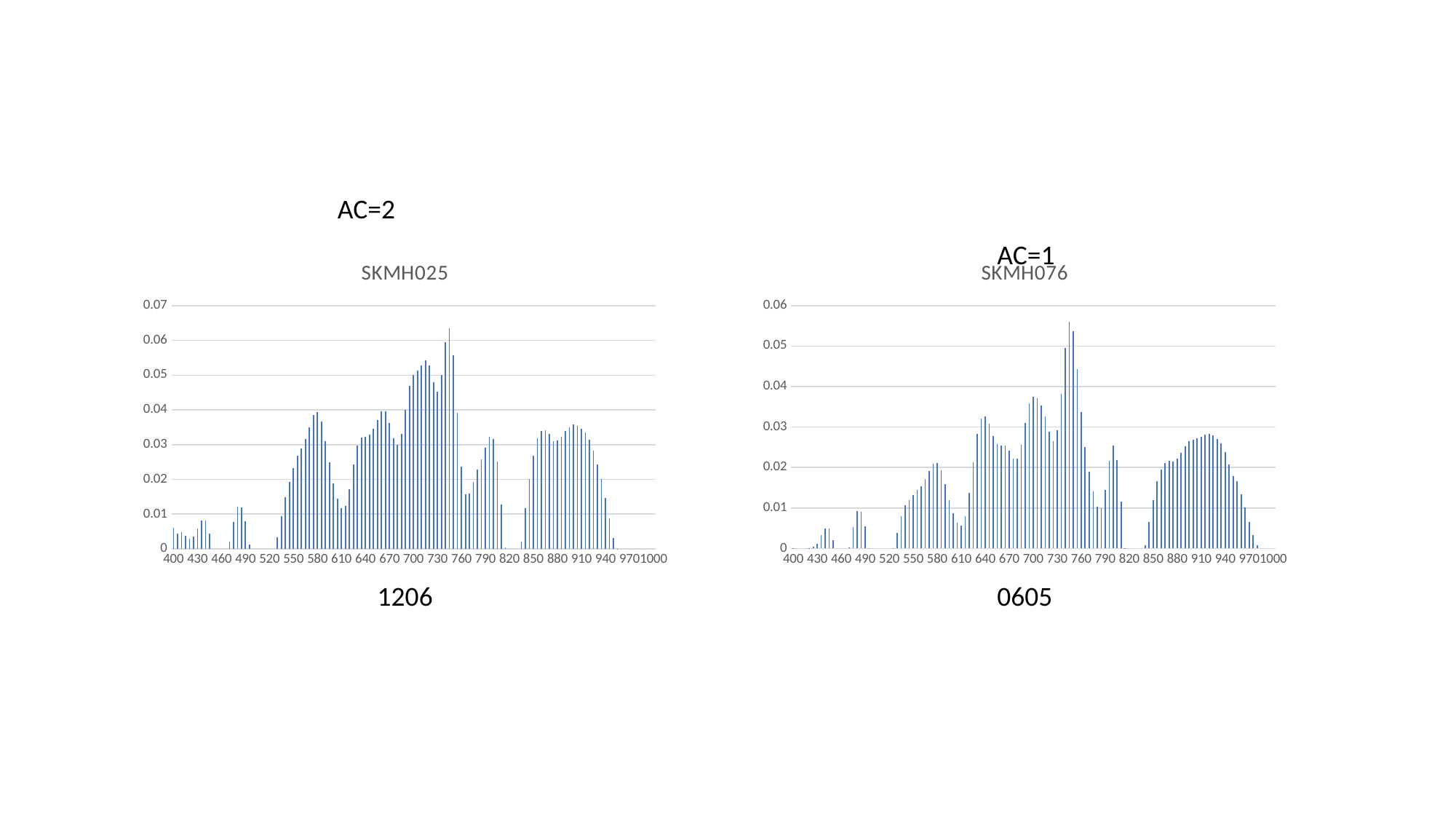
What is the title of the chart on the right? SKMH076 What is the title of the chart on the left? SKMH025 In the SKMH076 chart, is the tallest bar located near 640, near 740, or near 910 on the x axis? near 740 In the SKMH076 chart, is the value at 910 greater or less than 0.02? greater In the SKMH025 chart, is the value at 490 greater or less than 0.02? less What kind of chart is the SKMH025 chart on the left? bar chart In the SKMH025 chart, is the value at 880 larger or smaller than the value at 740? smaller In the SKMH076 chart, is the value at 460 greater or less than 0.01? less What kind of chart is the SKMH076 chart on the right? bar chart In the SKMH025 chart, is the tallest bar located near 580, near 740, or near 880 on the x axis? near 740